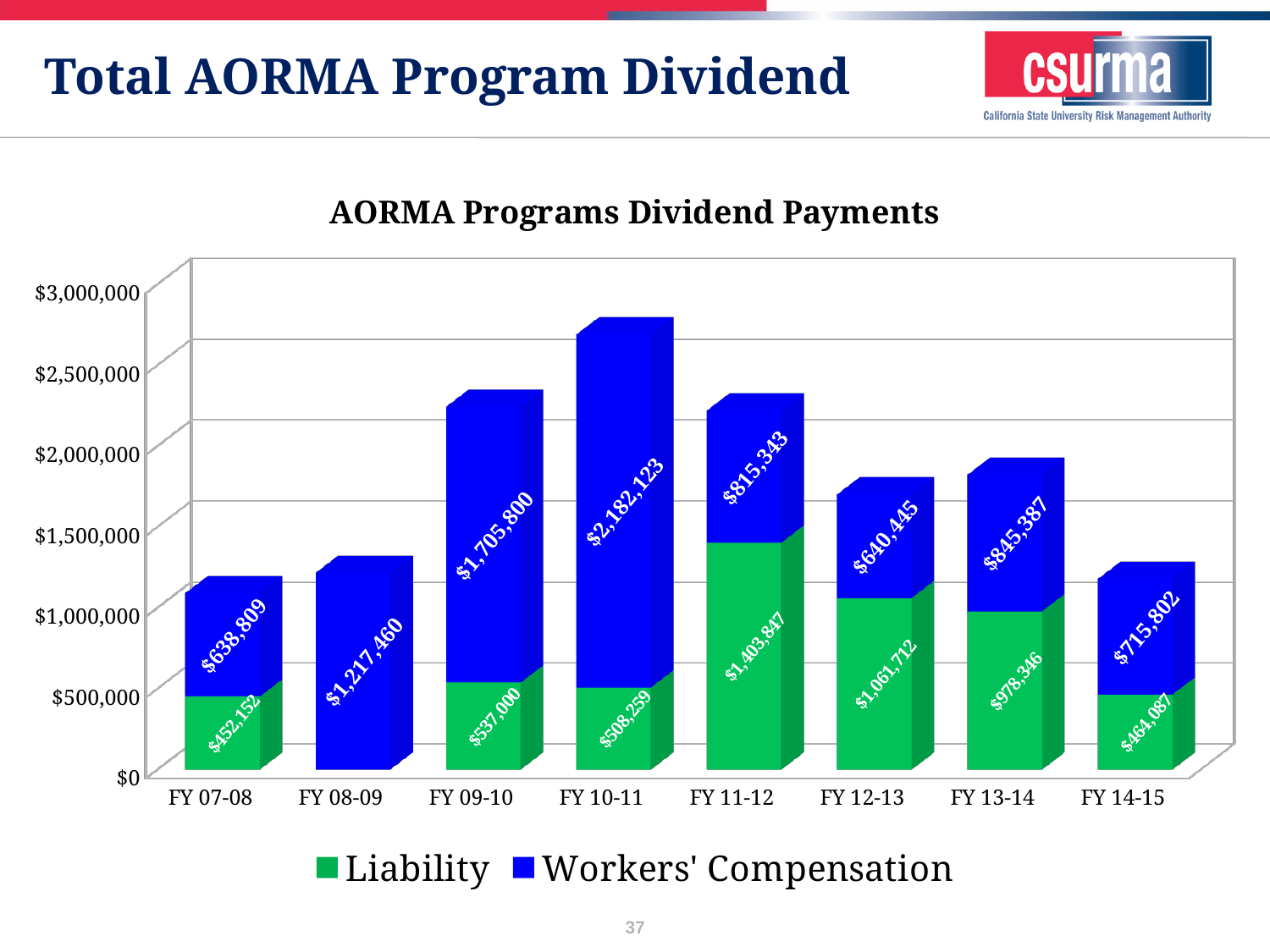
Which is larger, the Liability payment for FY 13-14 or the Workers' Compensation payment for FY 13-14? Liability ($978,346) What is the difference between the Workers' Compensation payments for FY 10-11 and FY 09-10? $476,323 How many fiscal years are shown on the x axis? 8 What is the Workers' Compensation dividend payment for FY 10-11? $2,182,123 Is the total dividend payment for FY 10-11 greater or less than $2,500,000? greater What is the Liability dividend payment for FY 11-12? $1,403,847 How many series does the legend list? 2 What is the total dividend payment for FY 07-08 (Liability plus Workers' Compensation)? $1,090,961 What is the Workers' Compensation dividend payment for FY 08-09? $1,217,460 Which fiscal year has the highest Liability dividend payment? FY 11-12 Which fiscal year has the highest Workers' Compensation dividend payment? FY 10-11 What type of chart is shown on the slide? Stacked bar chart